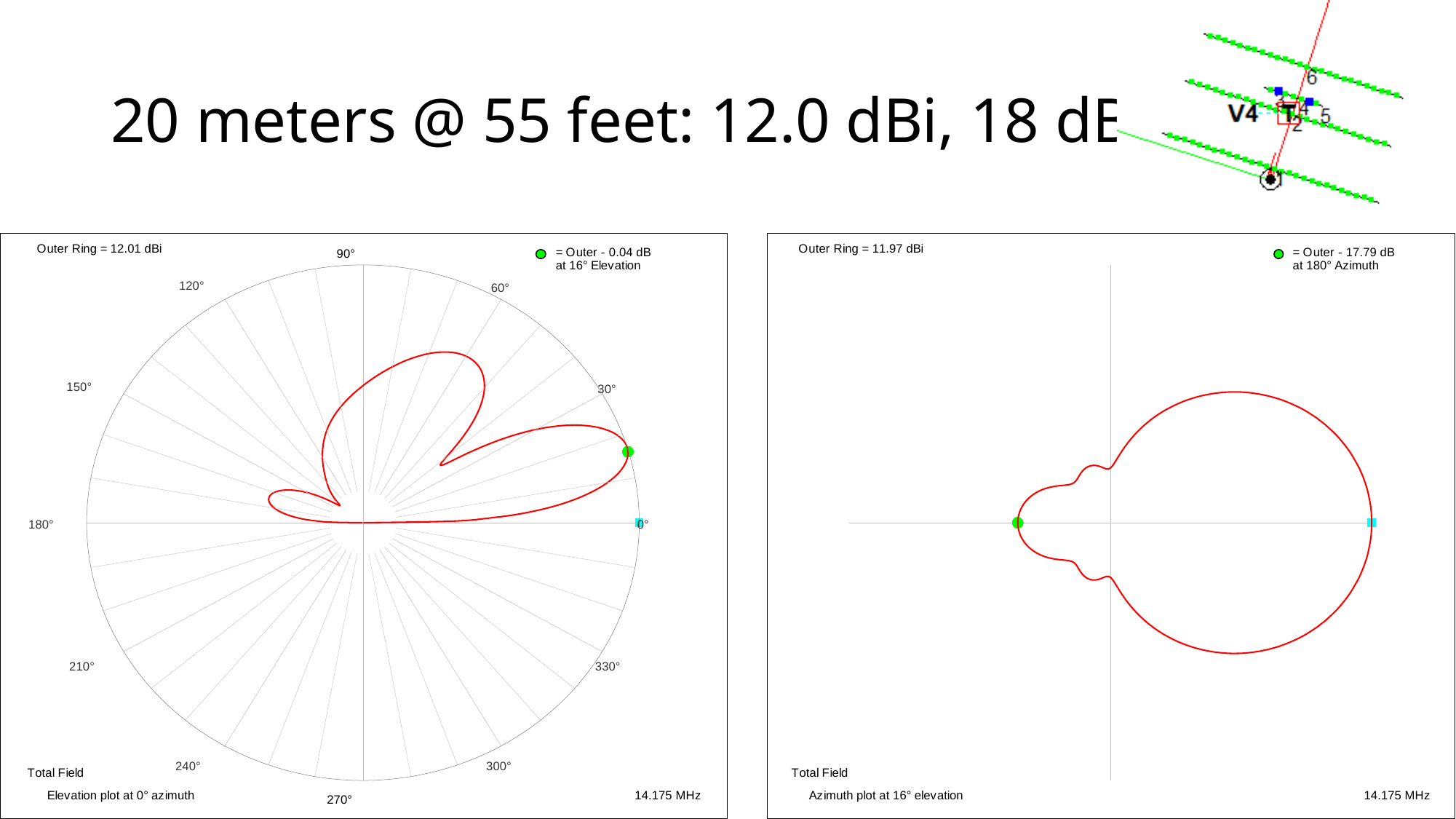
On the right chart, how far below the outer ring is the green marker? 17.79 dB On the right chart, is the pattern at 180° azimuth greater or less than 10 dB below the outer ring? greater Which chart has the larger outer ring value, the left elevation plot or the right azimuth plot? Left elevation plot What field type is labelled at the bottom left of both charts? Total Field On the left chart, at what elevation angle is the green marker placed? 16° What frequency is shown on the left chart? 14.175 MHz What kind of chart is the left chart? Polar plot On the right chart, at what azimuth angle is the green marker placed? 180° On the left chart, how far below the outer ring is the green marker? 0.04 dB What is the difference between the outer ring values of the left and right charts? 0.04 dBi On the left chart (Elevation plot at 0° azimuth), what is the value of the outer ring? 12.01 dBi On the right chart (Azimuth plot at 16° elevation), what is the value of the outer ring? 11.97 dBi